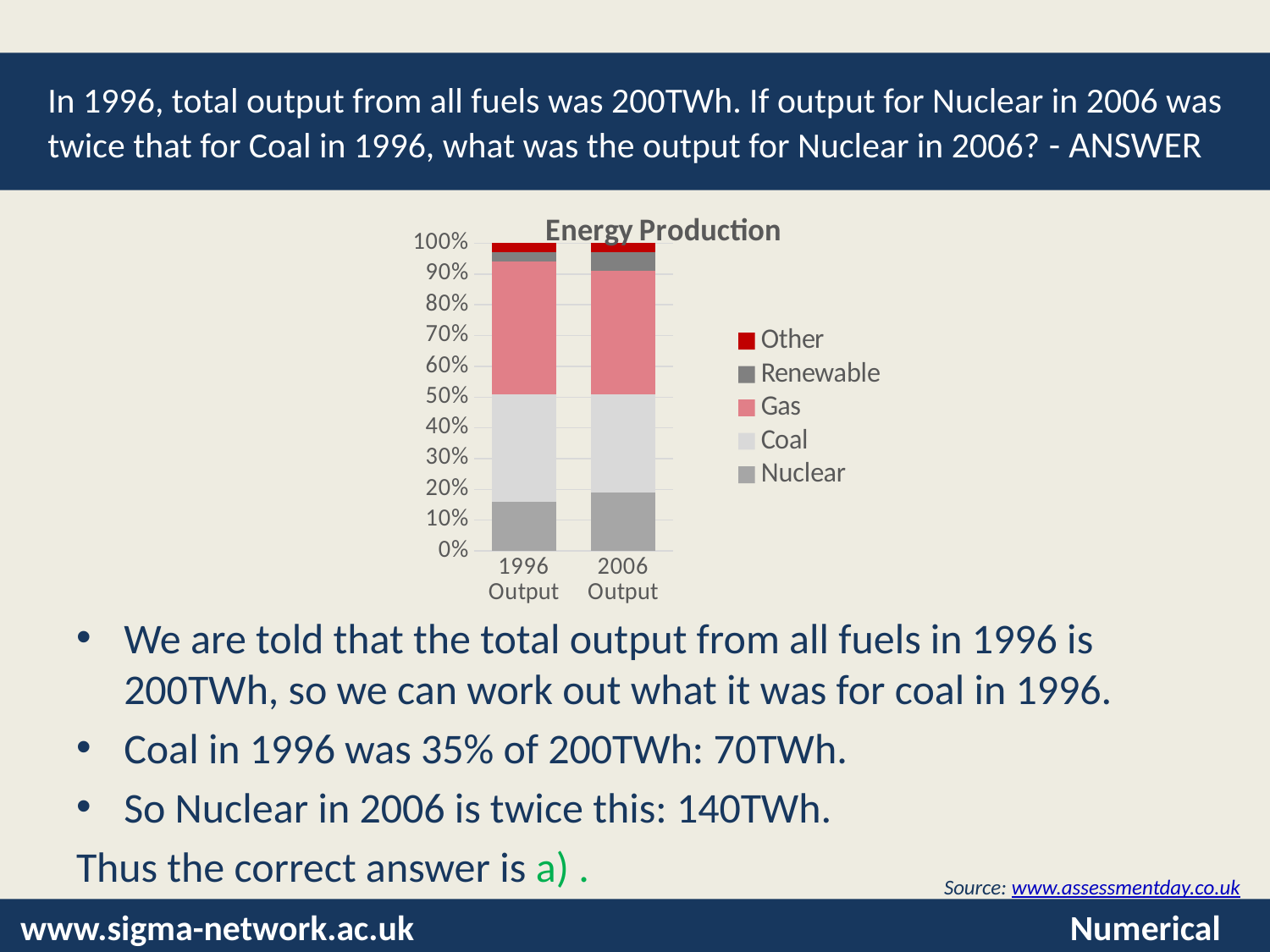
According to the slide, what percentage of 1996 output was Coal? 35% How many bars (categories) are plotted in the Energy Production chart? 2 Which fuel has the largest share of the 2006 Output bar? Gas Is the Nuclear share of the 1996 Output bar greater or less than 20%? less Is the Nuclear share larger in 1996 Output or 2006 Output? 2006 Output Is the Renewable share larger in 1996 Output or 2006 Output? 2006 Output Which fuel has the largest share of the 1996 Output bar? Gas What is the title of the chart? Energy Production What does each stacked bar in the chart total? 100% How many series does the chart legend list? 5 What type of chart is shown on the slide? stacked bar chart Is the Nuclear share of the 2006 Output bar greater or less than 10%? greater